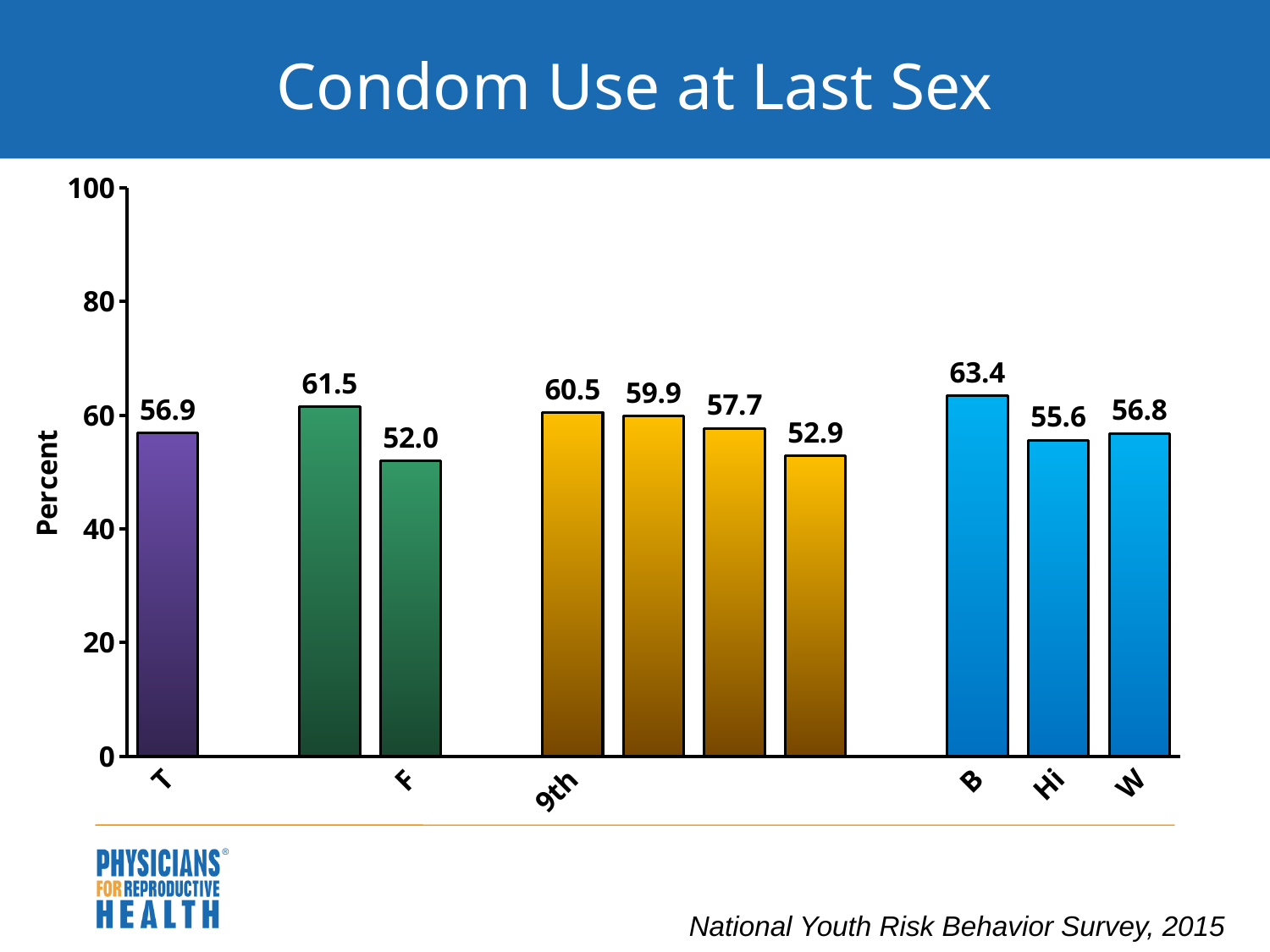
Which category has the lowest value? F What is the value for F? 52.0 What is the difference between the values for B and F? 11.4 What type of chart is shown on the slide? bar chart What is the value for B? 63.4 What is the value for T? 56.9 What is the value for Hi? 55.6 Which category has the highest value? B Which is larger, the value for B or the value for Hi? B Is the value for T greater or less than 60? less What is the label on the vertical axis? Percent What is the value for 9th? 60.5